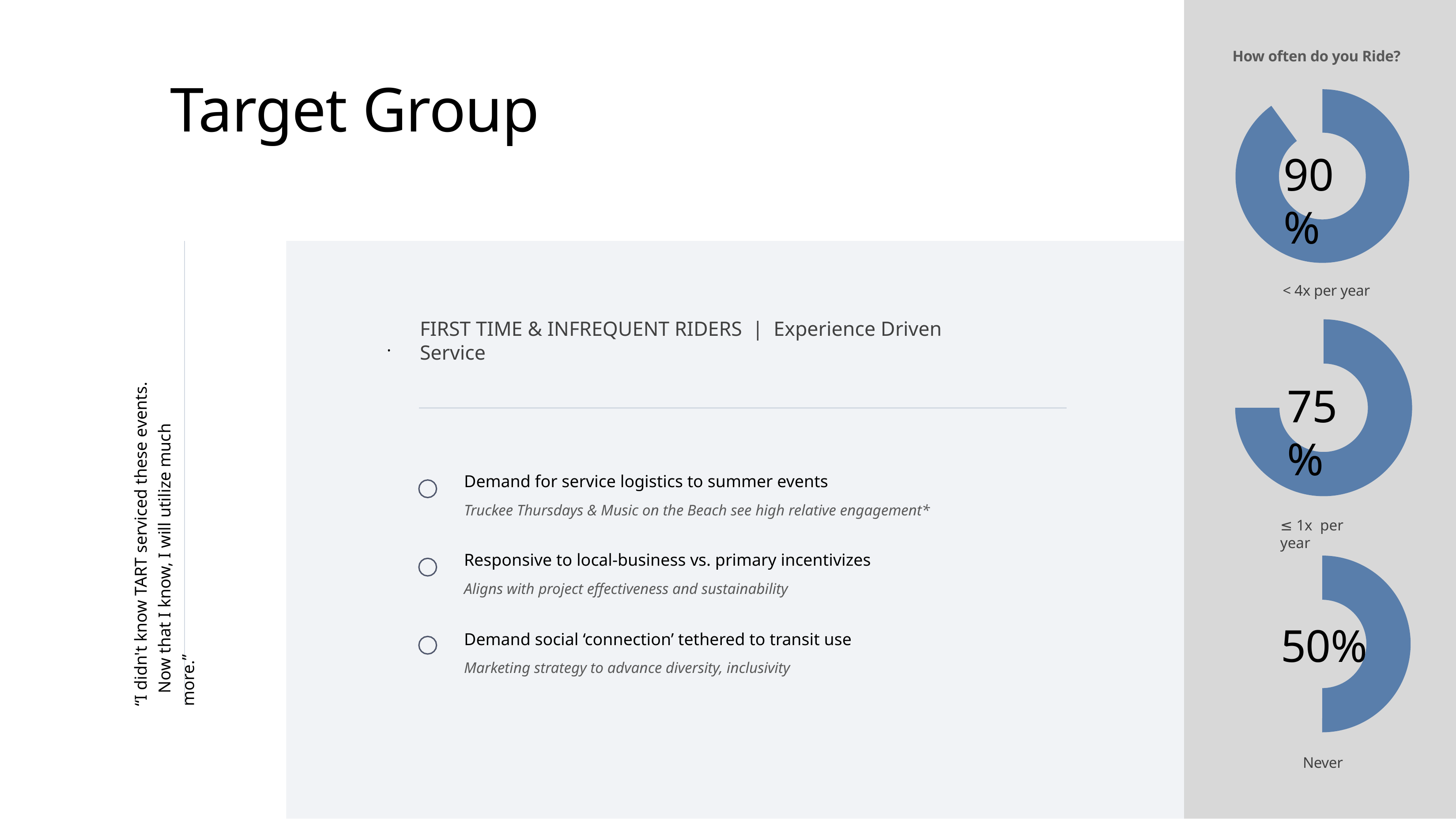
In the 'How often do you Ride?' charts, what percentage is shown for 'Never'? 50% Reading the 'How often do you Ride?' charts from top to bottom, do the percentages rise or fall? Fall In the 'How often do you Ride?' charts, what is the difference between the '< 4x per year' and '≤ 1x per year' percentages? 15% How many donut charts are shown under 'How often do you Ride?'? 3 Among the 'How often do you Ride?' charts, which category has the lowest percentage? Never In the 'How often do you Ride?' charts, what is the difference between the '< 4x per year' and 'Never' percentages? 40% In the 'How often do you Ride?' charts, which is larger: the percentage for '≤ 1x per year' or for 'Never'? ≤ 1x per year Among the 'How often do you Ride?' charts, which category has the highest percentage? < 4x per year In the 'How often do you Ride?' charts, what percentage is shown for '≤ 1x per year'? 75% What is the title above the three donut charts on the right of the slide? How often do you Ride? In the 'How often do you Ride?' charts, what percentage is shown for '< 4x per year'? 90% What kind of chart is used for the 'How often do you Ride?' figures? Donut (pie) chart